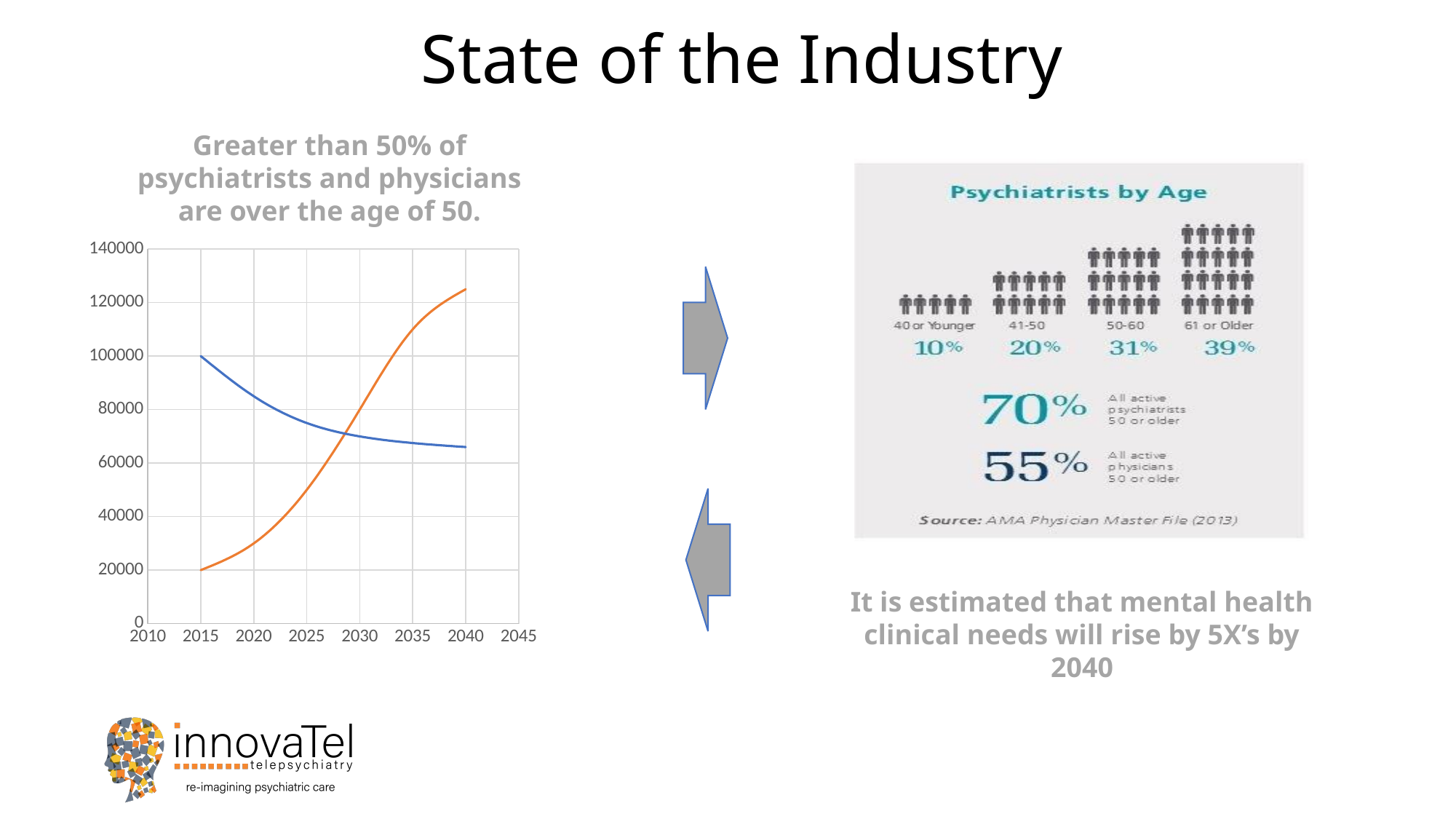
In the 'Psychiatrists by Age' graphic on the right, what percentage of psychiatrists are 61 or Older? 39% In the 'Psychiatrists by Age' graphic on the right, which age group has the largest share of psychiatrists? 61 or Older In the 'Psychiatrists by Age' graphic on the right, what is the difference in percentage points between the 61 or Older group and the 40 or Younger group? 29 In the line chart on the left, which line is higher in 2040, the blue line or the orange line? orange line In the 'Psychiatrists by Age' graphic on the right, what percentage of all active psychiatrists are 50 or older? 70% What kind of chart is the chart on the left of the slide? line chart In the 'Psychiatrists by Age' graphic on the right, which age group has the smallest share of psychiatrists? 40 or Younger In the line chart on the left, does the orange line rise or fall from 2015 to 2040? rise In the line chart on the left, is the value of the orange line in 2040 greater or less than 120000? greater In the line chart on the left, is the value of the blue line in 2040 greater or less than 80000? less In the line chart on the left, which line is higher in 2015, the blue line or the orange line? blue line In the line chart on the left, does the blue line rise or fall from 2015 to 2040? fall